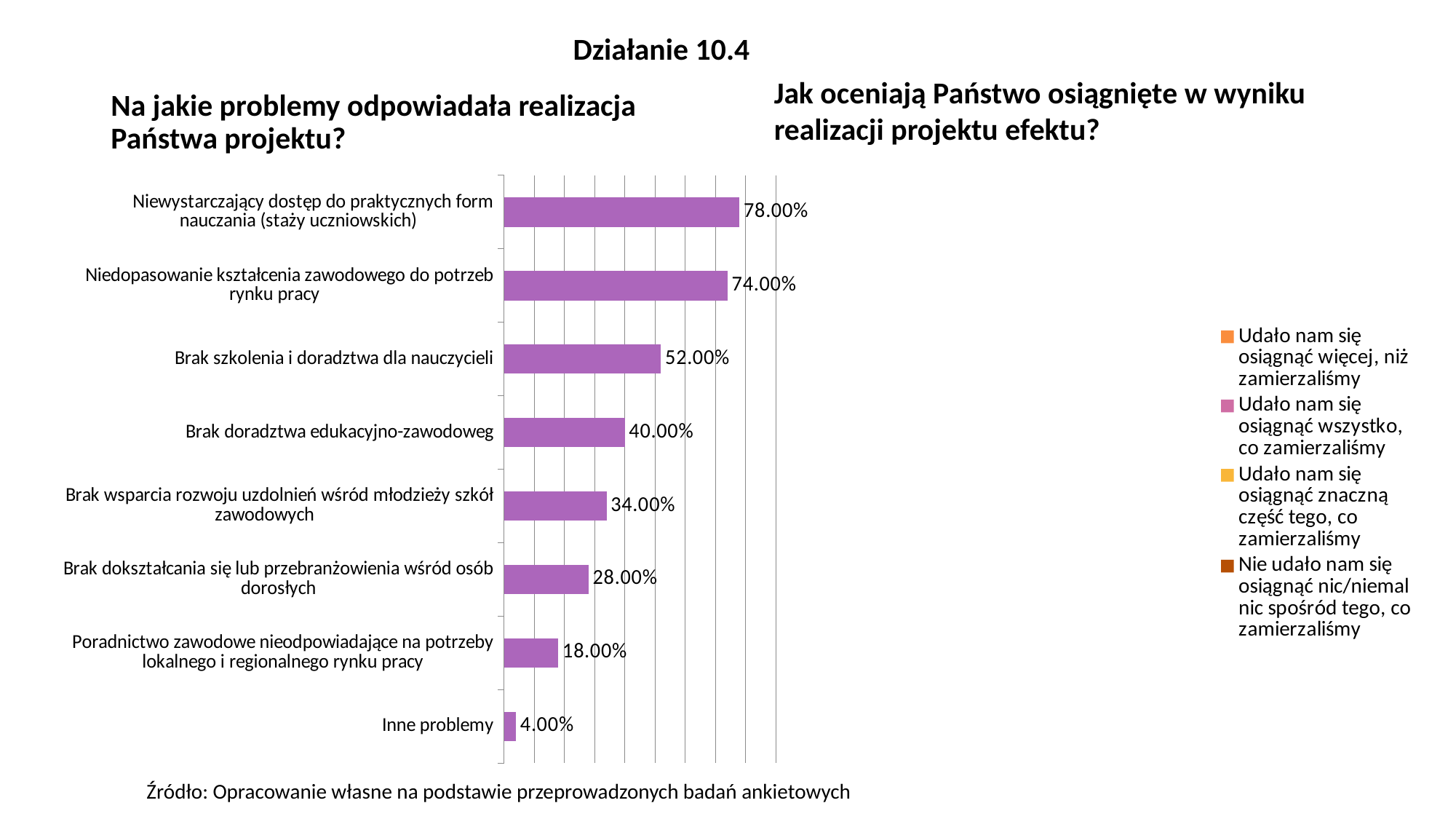
In the chart 'Na jakie problemy odpowiadała realizacja Państwa projektu?', which category has the highest value? Niewystarczający dostęp do praktycznych form nauczania (staży uczniowskich) In the chart 'Na jakie problemy odpowiadała realizacja Państwa projektu?', what colour are the bars? Purple In the chart 'Na jakie problemy odpowiadała realizacja Państwa projektu?', what is the difference between the values for 'Niewystarczający dostęp do praktycznych form nauczania (staży uczniowskich)' and 'Niedopasowanie kształcenia zawodowego do potrzeb rynku pracy'? 4.00% How many categories are shown in the chart 'Na jakie problemy odpowiadała realizacja Państwa projektu?'? 8 How many entries does the legend on the right side of the slide, under 'Jak oceniają Państwo osiągnięte w wyniku realizacji projektu efektu?', list? 4 In the chart 'Na jakie problemy odpowiadała realizacja Państwa projektu?', what is the value for 'Inne problemy'? 4.00% In the chart 'Na jakie problemy odpowiadała realizacja Państwa projektu?', which category has the lowest value? Inne problemy What kind of chart is 'Na jakie problemy odpowiadała realizacja Państwa projektu?'? Bar chart In the chart 'Na jakie problemy odpowiadała realizacja Państwa projektu?', which is larger: the value for 'Brak wsparcia rozwoju uzdolnień wśród młodzieży szkół zawodowych' or for 'Brak doradztwa edukacyjno-zawodoweg'? Brak doradztwa edukacyjno-zawodoweg In the chart 'Na jakie problemy odpowiadała realizacja Państwa projektu?', what is the value for 'Brak szkolenia i doradztwa dla nauczycieli'? 52.00% In the chart 'Na jakie problemy odpowiadała realizacja Państwa projektu?', what is the value for 'Brak dokształcania się lub przebranżowienia wśród osób dorosłych'? 28.00% In the chart 'Na jakie problemy odpowiadała realizacja Państwa projektu?', what is the difference between the values for 'Brak doradztwa edukacyjno-zawodoweg' and 'Poradnictwo zawodowe nieodpowiadające na potrzeby lokalnego i regionalnego rynku pracy'? 22.00%